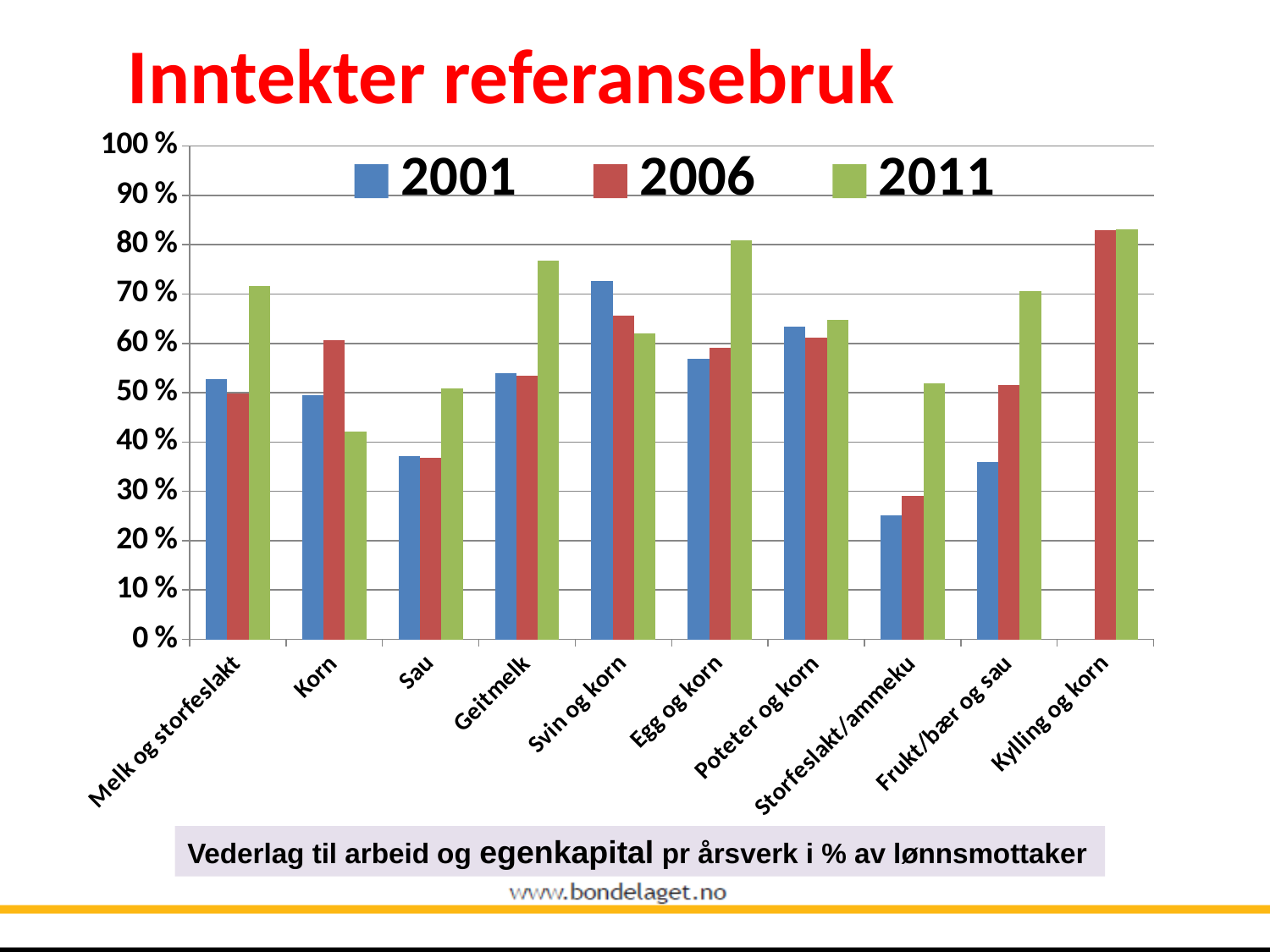
Which category has the lowest value for 2011? Korn Which category has the lowest value for 2001? Storfeslakt/ammeku For Svin og korn, do the values rise or fall from 2001 to 2011? fall What kind of chart is shown on the slide? Bar chart What is the title of the chart? Inntekter referansebruk Which category has the highest value for 2001? Svin og korn Is the value for Storfeslakt/ammeku in 2001 greater or less than 30 %? less How many series does the legend list? 3 How many categories are shown on the x axis? 10 For Korn, which is larger: the value for 2006 or the value for 2011? 2006 Is the value for Geitmelk in 2011 greater or less than 70 %? greater Is the value for Svin og korn in 2001 greater or less than 70 %? greater